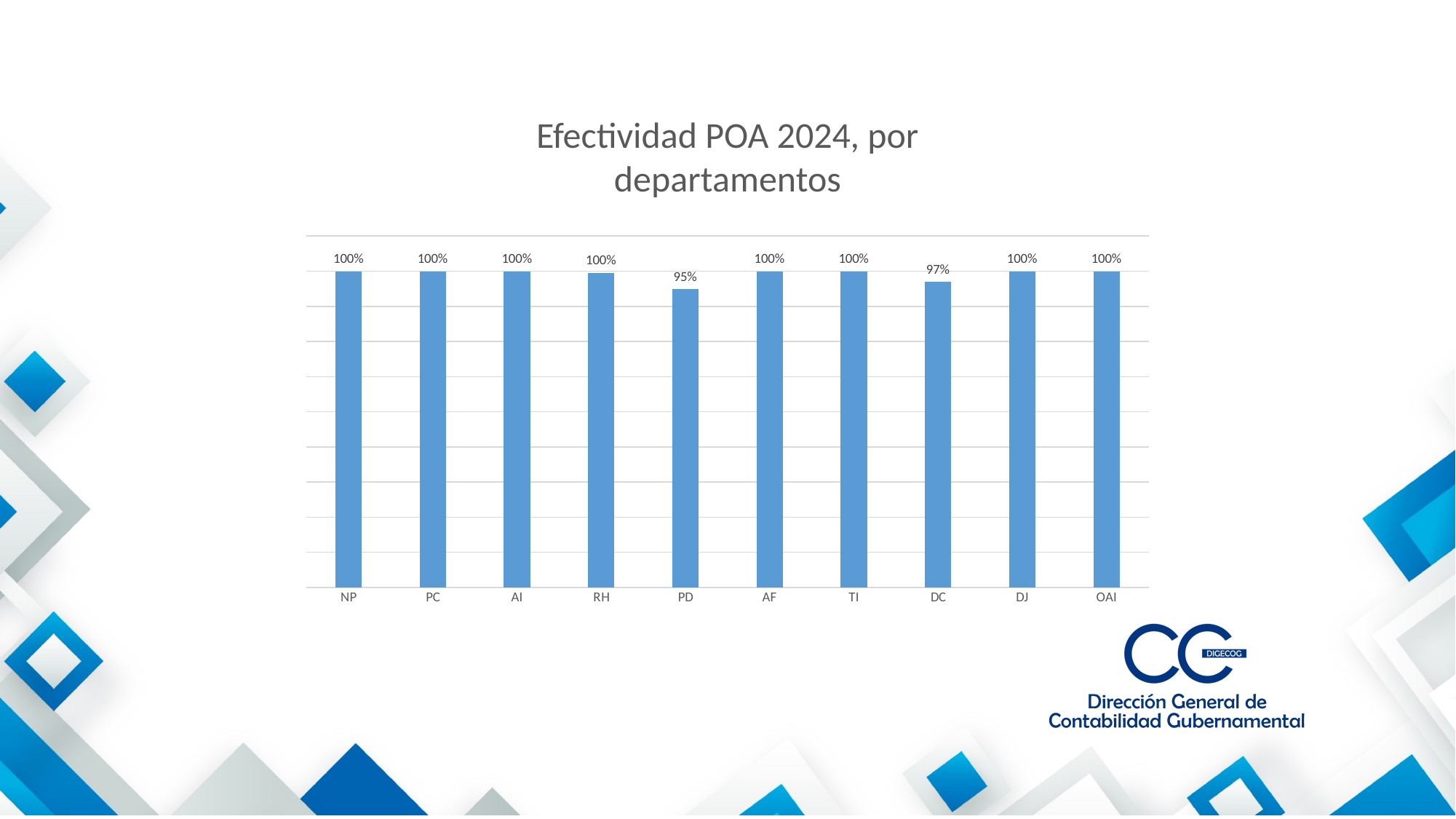
Which is larger, the value for TI or the value for DC? TI Which is larger, the value for DC or the value for PD? DC What is the value for OAI? 100% Which department has the lowest value? PD How many departments are shown on the x axis? 10 What is the title of the chart? Efectividad POA 2024, por departamentos What kind of chart is this? Bar chart What is the value for PD? 95% What is the value for DC? 97% What is the difference between the values for NP and PD? 5% What is the difference between the values for DC and PD? 2% What is the value for NP? 100%